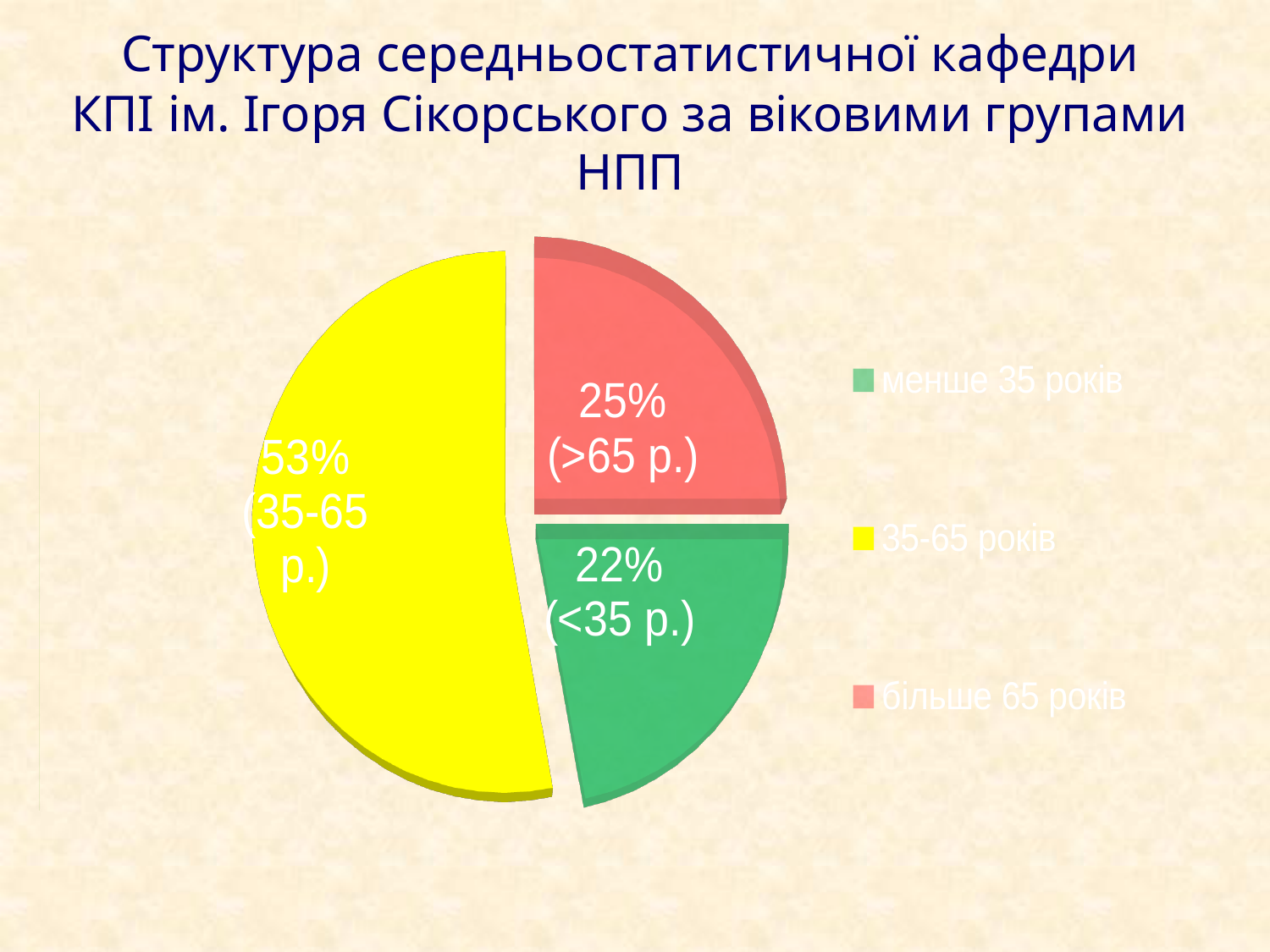
What share of the pie does the "менше 35 років" group have? 22% Which is larger: the slice for "більше 65 років" or the slice for "менше 35 років"? більше 65 років How many slices does the pie chart have? 3 What is the difference in percentage points between the "більше 65 років" slice and the "менше 35 років" slice? 3 How many entries does the legend list? 3 Which age group has the largest slice of the pie? 35-65 років What kind of chart is shown on the slide? pie chart Which age group has the smallest slice of the pie? менше 35 років What share of the pie does the "35-65 років" group have? 53% What colour is the slice for "35-65 років"? yellow What share of the pie does the "більше 65 років" group have? 25% What is the difference in percentage points between the "35-65 років" slice and the "більше 65 років" slice? 28